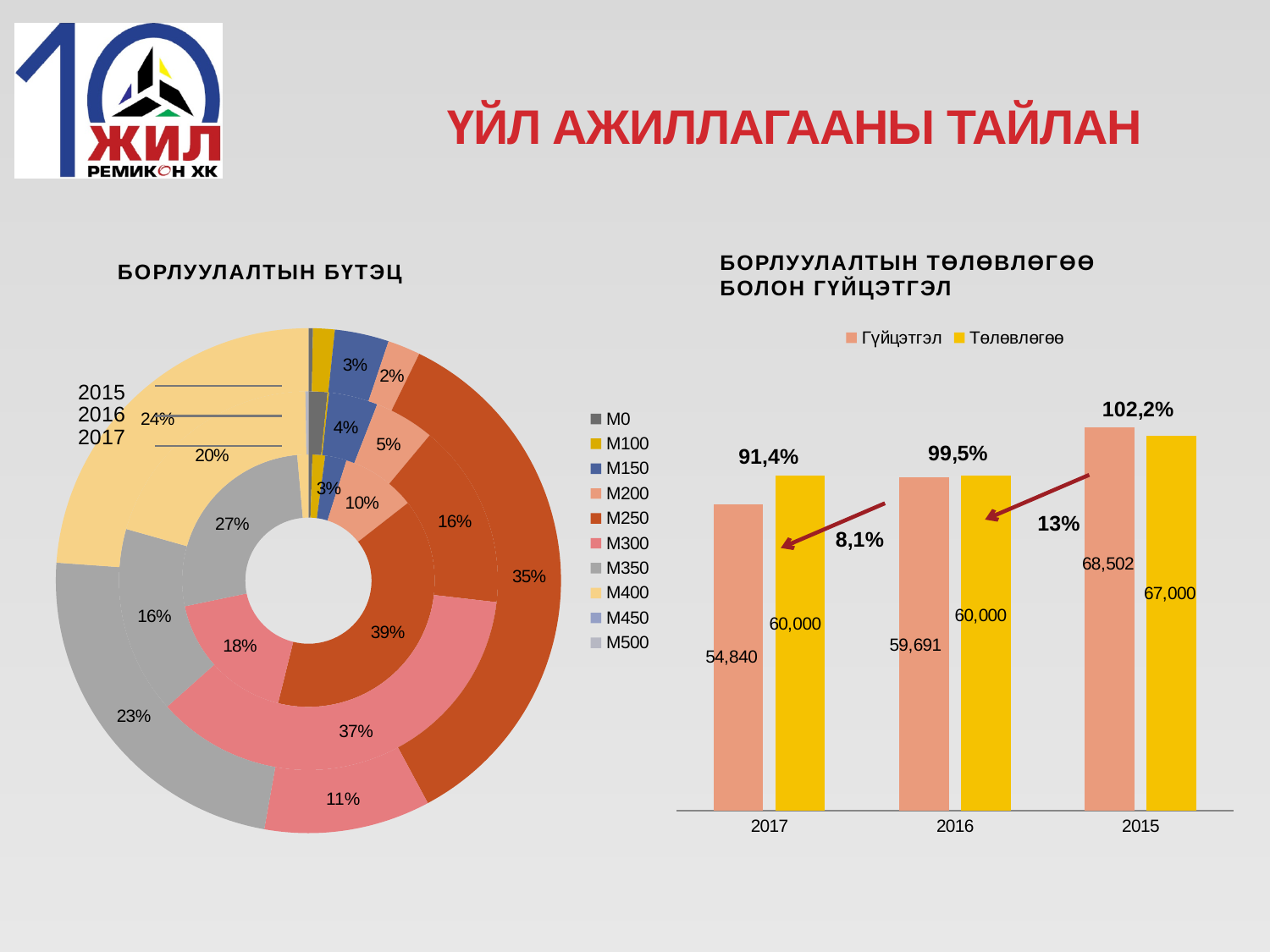
In the right-hand bar chart, what is the Гүйцэтгэл value for 2016? 59,691 What kind of chart is the chart titled 'БОРЛУУЛАЛТЫН ТӨЛӨВЛӨГӨӨ БОЛОН ГҮЙЦЭТГЭЛ' on the right? Bar chart How many series does the legend of the right-hand bar chart list? 2 In the right-hand bar chart, what is the difference between the Гүйцэтгэл and Төлөвлөгөө values for 2015? 1,502 How many entries does the legend of the left-hand chart 'БОРЛУУЛАЛТЫН БҮТЭЦ' list? 10 In the right-hand bar chart, what is the Гүйцэтгэл value for 2017? 54,840 In the right-hand bar chart, which year has the highest Гүйцэтгэл value? 2015 In the right-hand bar chart, what is the difference between the Төлөвлөгөө and Гүйцэтгэл values for 2017? 5,160 In the right-hand bar chart, what is the Төлөвлөгөө value for 2015? 67,000 In the right-hand bar chart, what percentage label is shown above the 2016 bars? 99,5% How many years are shown on the x axis of the right-hand bar chart? 3 In the right-hand bar chart, which is larger for 2017: Гүйцэтгэл or Төлөвлөгөө? Төлөвлөгөө